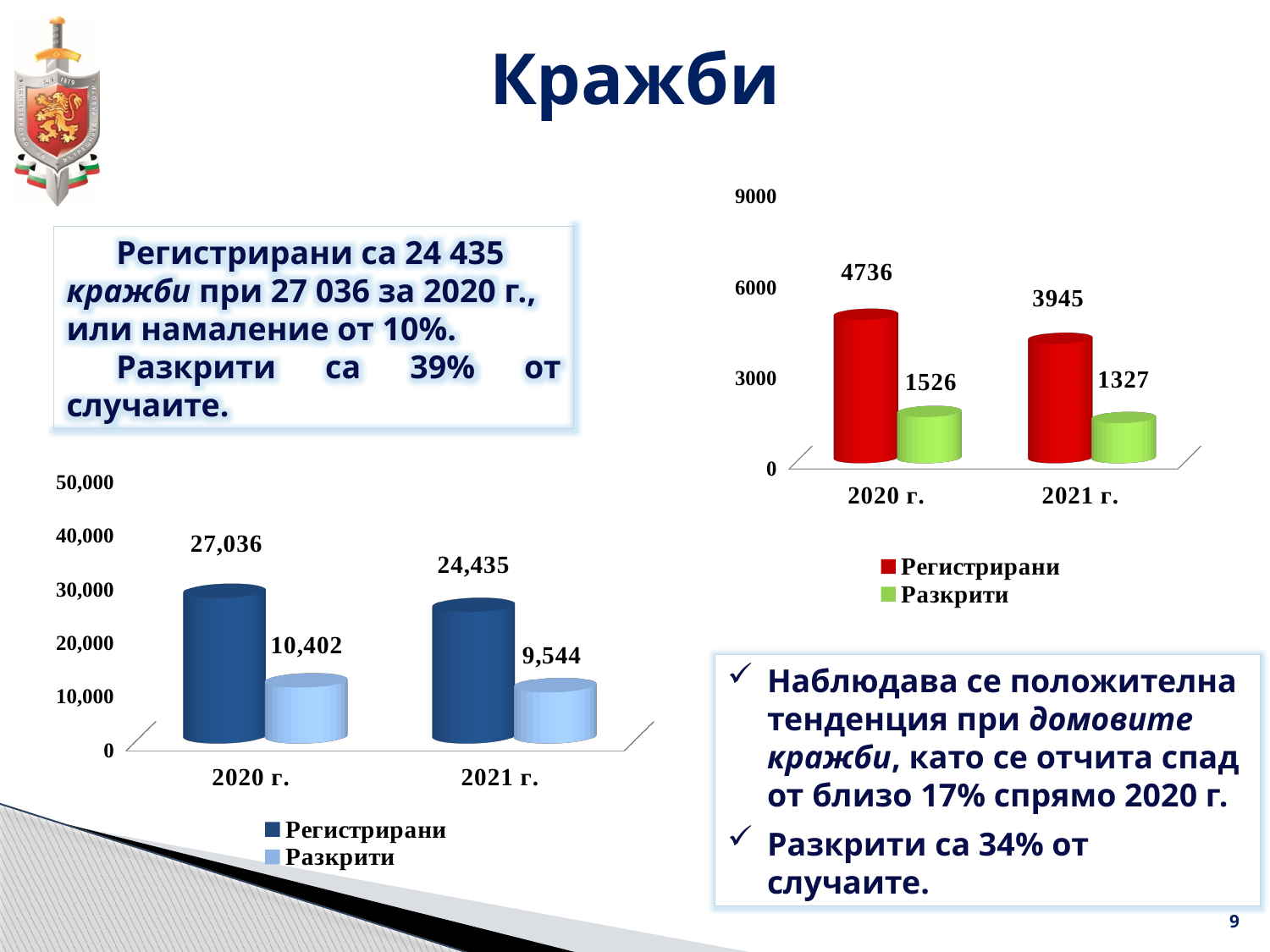
In the bottom-left chart, how many series does the legend list? 2 In the bottom-left chart, what is the value of Разкрити for 2021 г.? 9,544 What kind of chart is the bottom-left chart? Bar chart In the bottom-left chart, by how much did Регистрирани decrease from 2020 г. to 2021 г.? 2,601 In the bottom-left chart, which year has the higher value for Разкрити? 2020 г. In the top-right chart, what is the difference between Разкрити in 2020 г. and 2021 г.? 199 In the top-right chart, do the Регистрирани values rise or fall from 2020 г. to 2021 г.? Fall In the top-right chart, what colour are the Разкрити bars? Green In the bottom-left chart, what is the value of Регистрирани for 2020 г.? 27,036 In the top-right chart, how many year categories are shown on the x axis? 2 In the top-right chart, what is the value of Разкрити for 2020 г.? 1526 In the top-right chart, what is the value of Регистрирани for 2021 г.? 3945